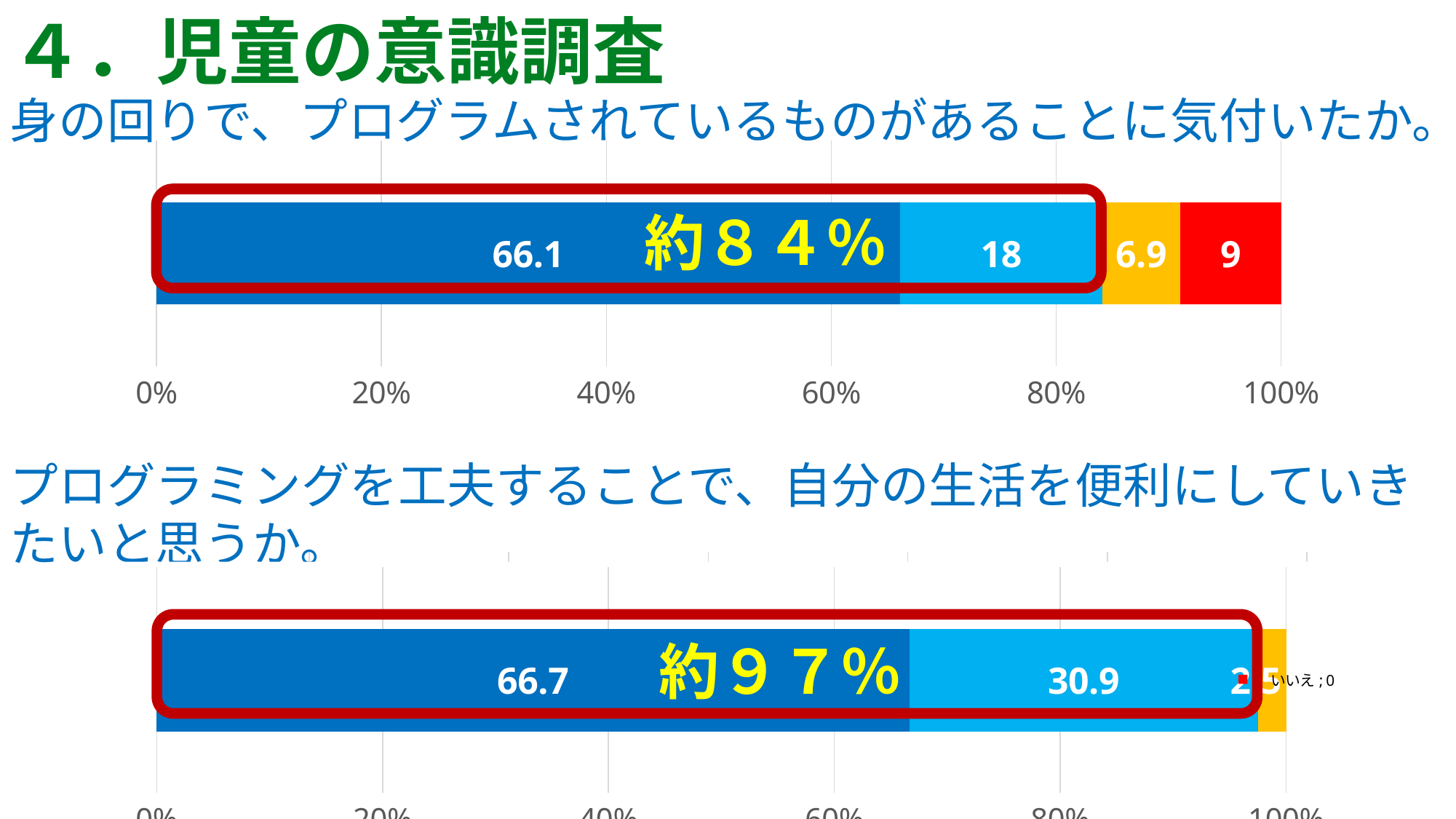
In the bottom chart, what is the value of the light blue segment? 30.9 In the top chart (身の回りで、プログラムされているものがあることに気付いたか。), what is the value of the dark blue segment? 66.1 In the top chart, what is the value of the red segment? 9 In the top chart, what is the difference between the dark blue segment and the light blue segment? 48.1 In the top chart, which is larger: the red segment or the yellow segment? The red segment (9) In the bottom chart, what value is shown for いいえ? 0 In the top chart, which segment has the largest value? The dark blue segment (66.1) In the bottom chart (プログラミングを工夫することで、自分の生活を便利にしていきたいと思うか。), what is the value of the dark blue segment? 66.7 In the top chart, what is the value of the light blue segment? 18 What type of chart is used on this slide? Stacked bar chart In the top chart, which segment has the smallest value? The yellow segment (6.9) In the top chart, what is the value of the yellow segment? 6.9